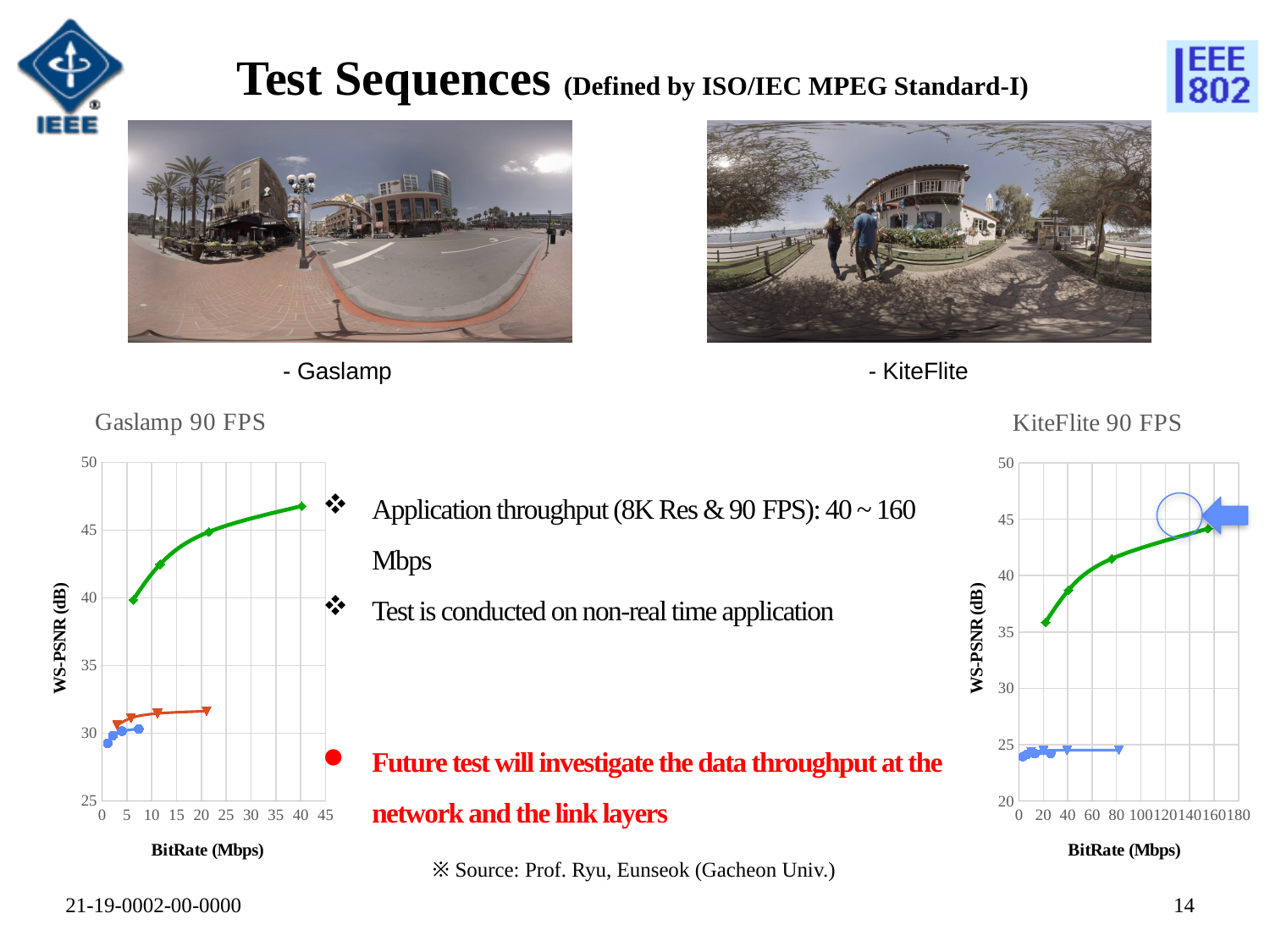
In the Gaslamp 90 FPS chart, which series has the lowest WS-PSNR values: the green, orange or blue one? blue What kind of chart is the Gaslamp 90 FPS chart? line chart In the Gaslamp 90 FPS chart, is the WS-PSNR of the green series at 40 Mbps greater or less than 45? greater What is the x-axis title of the KiteFlite 90 FPS chart? BitRate (Mbps) In the KiteFlite 90 FPS chart, does the green series rise or fall as BitRate increases? rises In the Gaslamp 90 FPS chart, does the green series rise or fall as BitRate increases? rises In the KiteFlite 90 FPS chart, which series has higher WS-PSNR values, the green or the blue one? green In the KiteFlite 90 FPS chart, is the WS-PSNR of the blue series at 80 Mbps greater or less than 30? less In the KiteFlite 90 FPS chart, is the WS-PSNR of the green series at 160 Mbps greater or less than 40? greater In the Gaslamp 90 FPS chart, which series reaches the highest WS-PSNR: the green, orange or blue one? green What kind of chart is the KiteFlite 90 FPS chart? line chart